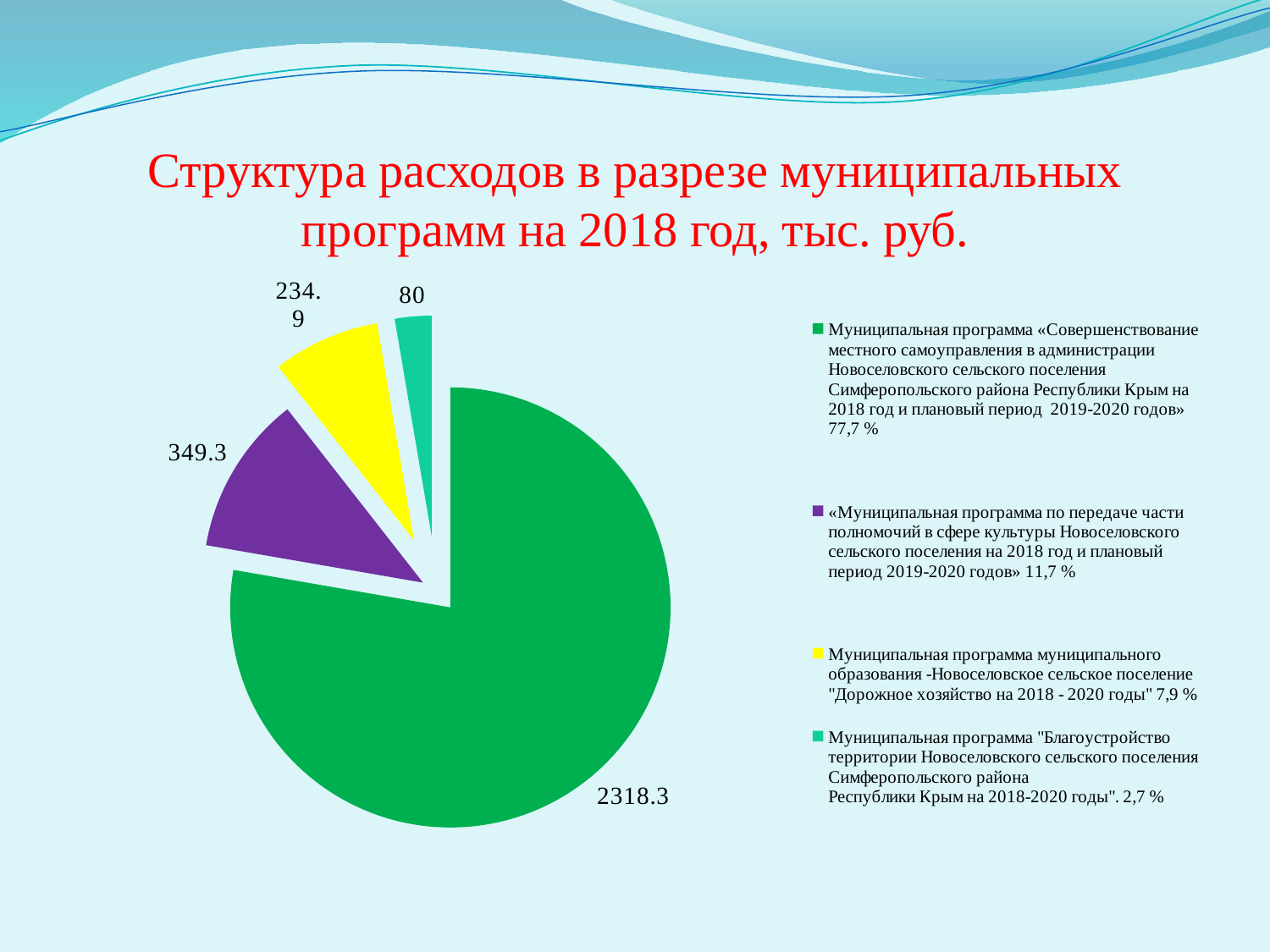
What type of chart is shown on the slide? Pie chart What is the value of the smallest slice (the territory improvement programme «Благоустройство»)? 80 How many slices does the pie chart have? 4 Which programme has the smallest share of expenditures? Муниципальная программа "Благоустройство территории Новоселовского сельского поселения Симферопольского района Республики Крым на 2018-2020 годы" What percentage share does the local self-government improvement programme (green slice) have according to the legend? 77,7 % What is the difference between the purple slice (349.3) and the yellow slice (234.9)? 114.4 What is the value of the purple slice (the programme on transferring powers in the sphere of culture)? 349.3 How many entries does the legend list? 4 What is the value of the largest slice (the green one, the local self-government improvement programme)? 2318.3 What is the value of the yellow slice (the road management programme «Дорожное хозяйство»)? 234.9 Which is larger: the value for the culture powers programme (purple) or the road management programme (yellow)? The culture powers programme (purple), 349.3 What percentage share does the road management programme «Дорожное хозяйство» (yellow slice) have according to the legend? 7,9 %